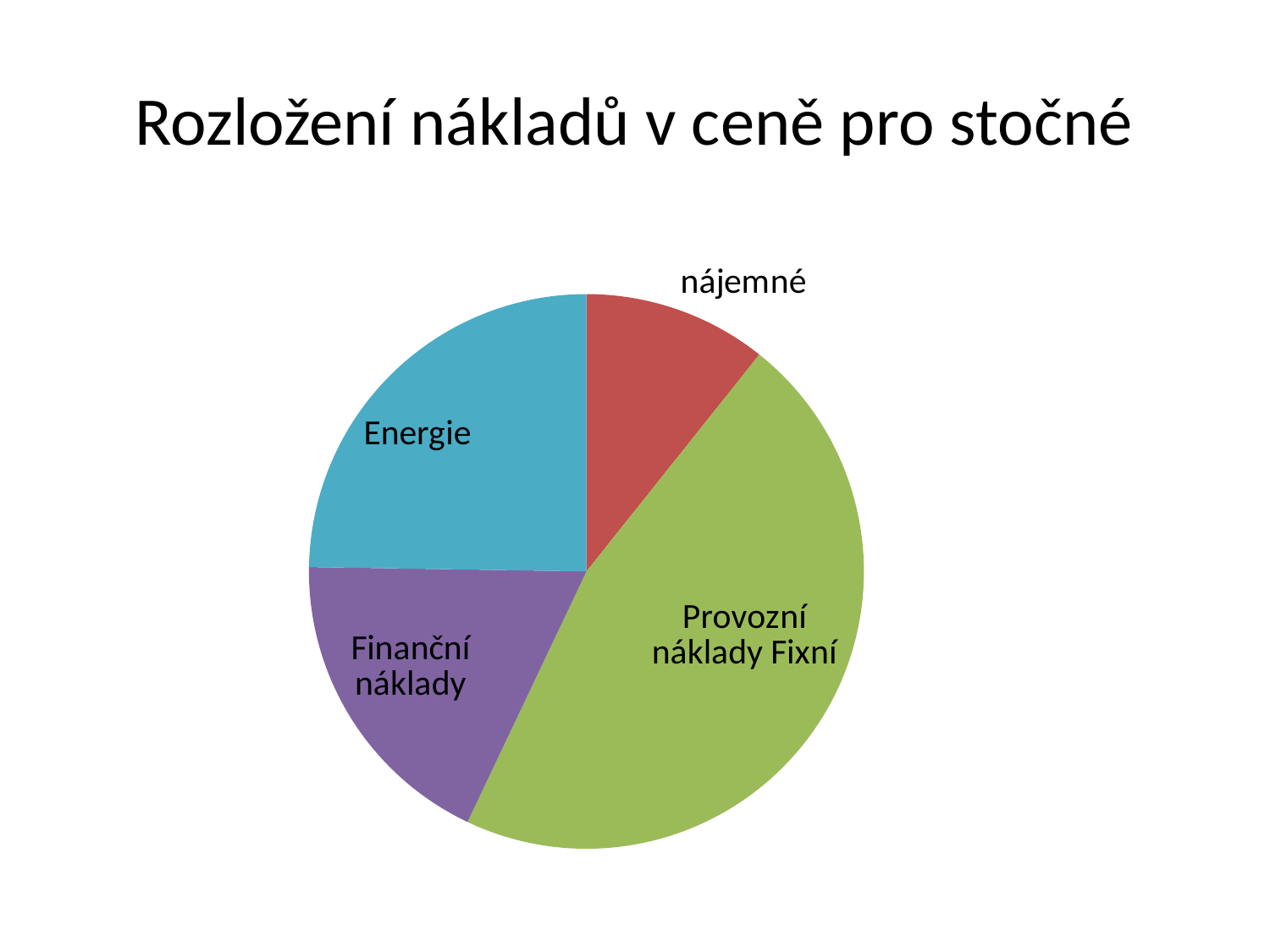
Which slice is larger, Provozní náklady Fixní or Finanční náklady? Provozní náklady Fixní Which category has the largest slice of the pie? Provozní náklady Fixní How many slices does the pie chart have? 4 Which slice is larger, Provozní náklady Fixní or Energie? Provozní náklady Fixní What is the title of the chart? Rozložení nákladů v ceně pro stočné Which slice is larger, Energie or nájemné? Energie What colour is the Energie slice? blue What kind of chart is shown on the slide? pie chart